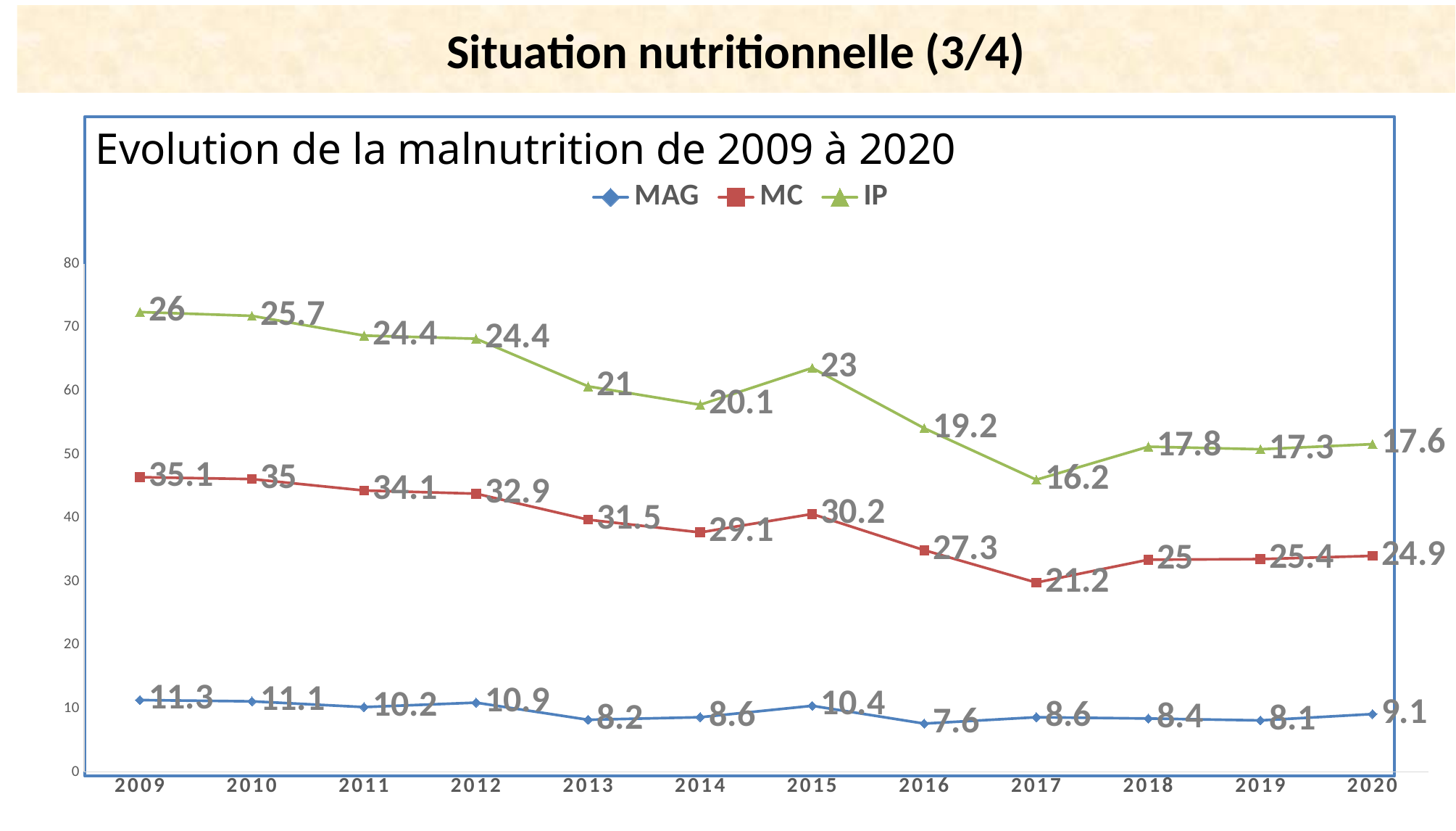
What is the difference between the IP values in 2009 and 2020? 8.4 Which is larger, the MC value in 2018 or the MC value in 2019? 2019 Does the MC series generally rise or fall from 2009 to 2020? Fall What is the value of MAG in 2015? 10.4 In which year is the MAG value lowest? 2016 What is the title of the chart? Evolution de la malnutrition de 2009 à 2020 What is the value of MC in 2012? 32.9 In which year is the MC value highest? 2009 How many series does the legend list? 3 What kind of chart is shown? Line chart What is the value of IP in 2017? 16.2 How many years are shown on the x axis? 12